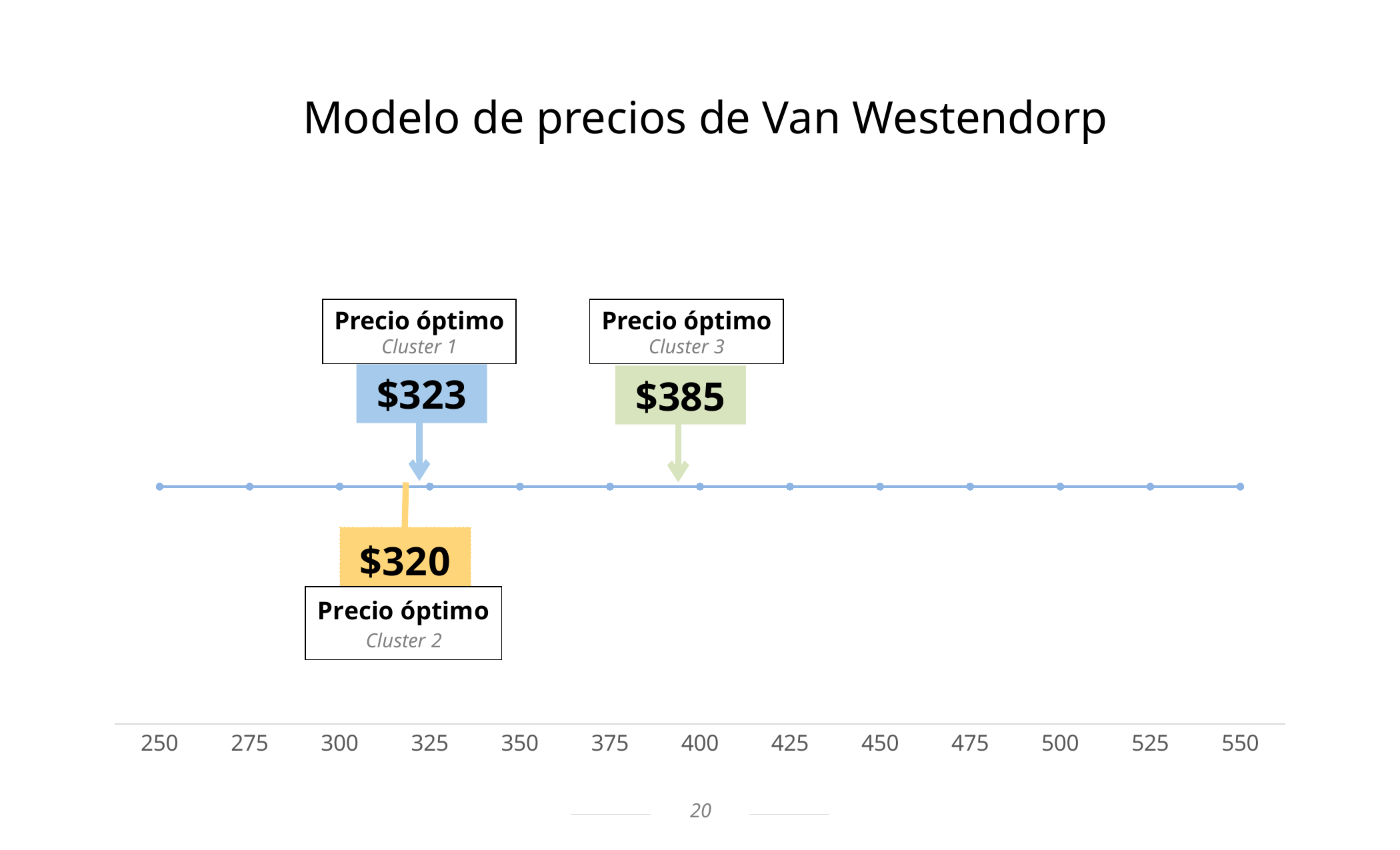
Which cluster has the lowest optimal price? Cluster 2 What is the lowest value shown on the price axis? 250 What is the title of the chart? Modelo de precios de Van Westendorp Which cluster has the highest optimal price? Cluster 3 What is the optimal price (Precio óptimo) for Cluster 2? $320 What is the optimal price (Precio óptimo) for Cluster 1? $323 What is the optimal price (Precio óptimo) for Cluster 3? $385 What is the difference between the optimal prices of Cluster 3 and Cluster 1? $62 Is the optimal price for Cluster 3 greater or less than 400? less What is the difference between the optimal prices of Cluster 1 and Cluster 2? $3 Which is larger, the optimal price for Cluster 1 or for Cluster 2? Cluster 1 How many clusters have an optimal price marked on the chart? 3